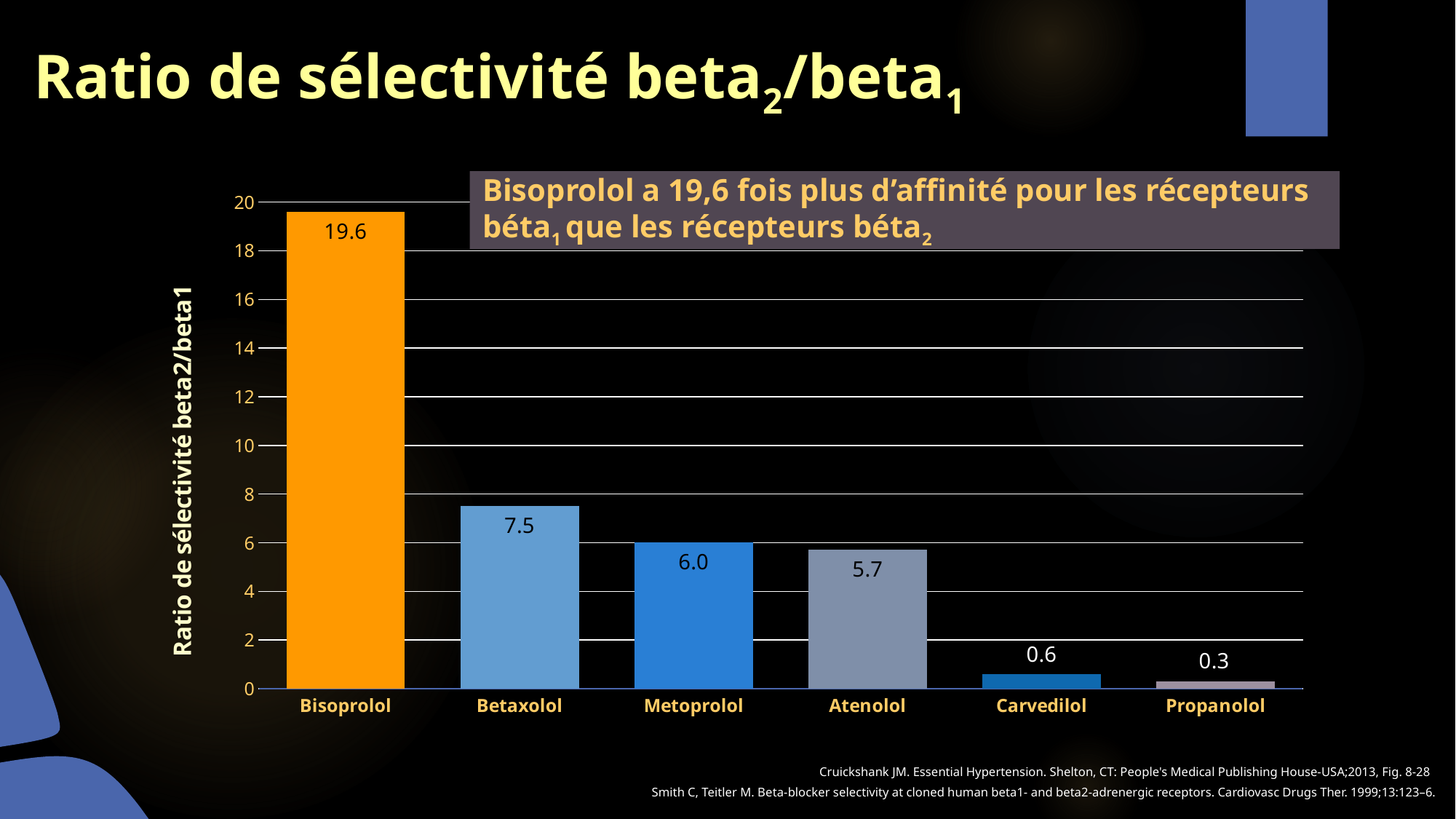
What is the selectivity ratio shown for Carvedilol? 0.6 Is the value for Betaxolol greater or less than 8? less What kind of chart is shown on the slide? Bar chart Which has a larger selectivity ratio, Betaxolol or Atenolol? Betaxolol What is the difference between the selectivity ratios of Bisoprolol and Betaxolol? 12.1 What is the difference between the selectivity ratios of Metoprolol and Atenolol? 0.3 Which drug has the lowest selectivity ratio? Propanolol What is the label of the vertical axis? Ratio de sélectivité beta2/beta1 How many drugs are shown on the x axis? 6 What is the beta2/beta1 selectivity ratio for Bisoprolol? 19.6 Which drug has the highest selectivity ratio? Bisoprolol What is the selectivity ratio shown for Metoprolol? 6.0